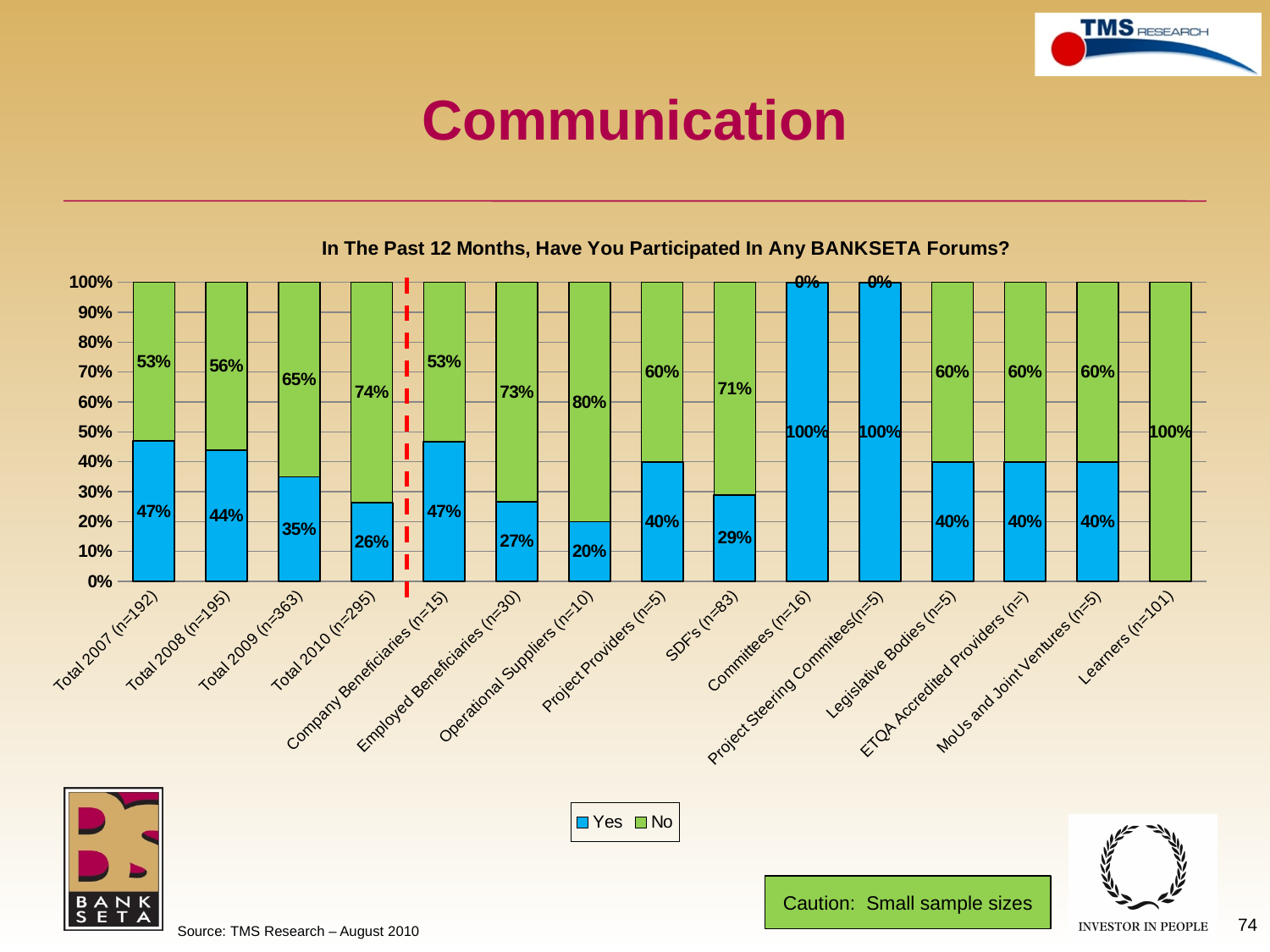
How many respondent groups are shown along the x axis? 15 Among the four Total year groups (2007 to 2010), which has the lowest Yes percentage? Total 2010 (n=295) By how many percentage points does the Yes share for Total 2007 exceed the Yes share for Total 2010? 21 percentage points Does the Yes percentage rise or fall from Total 2007 to Total 2010? Fall Which group has a higher Yes percentage: Employed Beneficiaries (n=30) or Operational Suppliers (n=10)? Employed Beneficiaries (n=30) How many series does the legend list? 2 What is the Yes percentage for SDF's (n=83)? 29% What percentage of Total 2010 (n=295) respondents answered Yes? 26% What kind of chart is used on this slide? Stacked bar chart Among the four Total year groups (2007 to 2010), which has the highest Yes percentage? Total 2007 (n=192) What percentage of Learners (n=101) answered No? 100% What percentage of Operational Suppliers (n=10) answered No? 80%